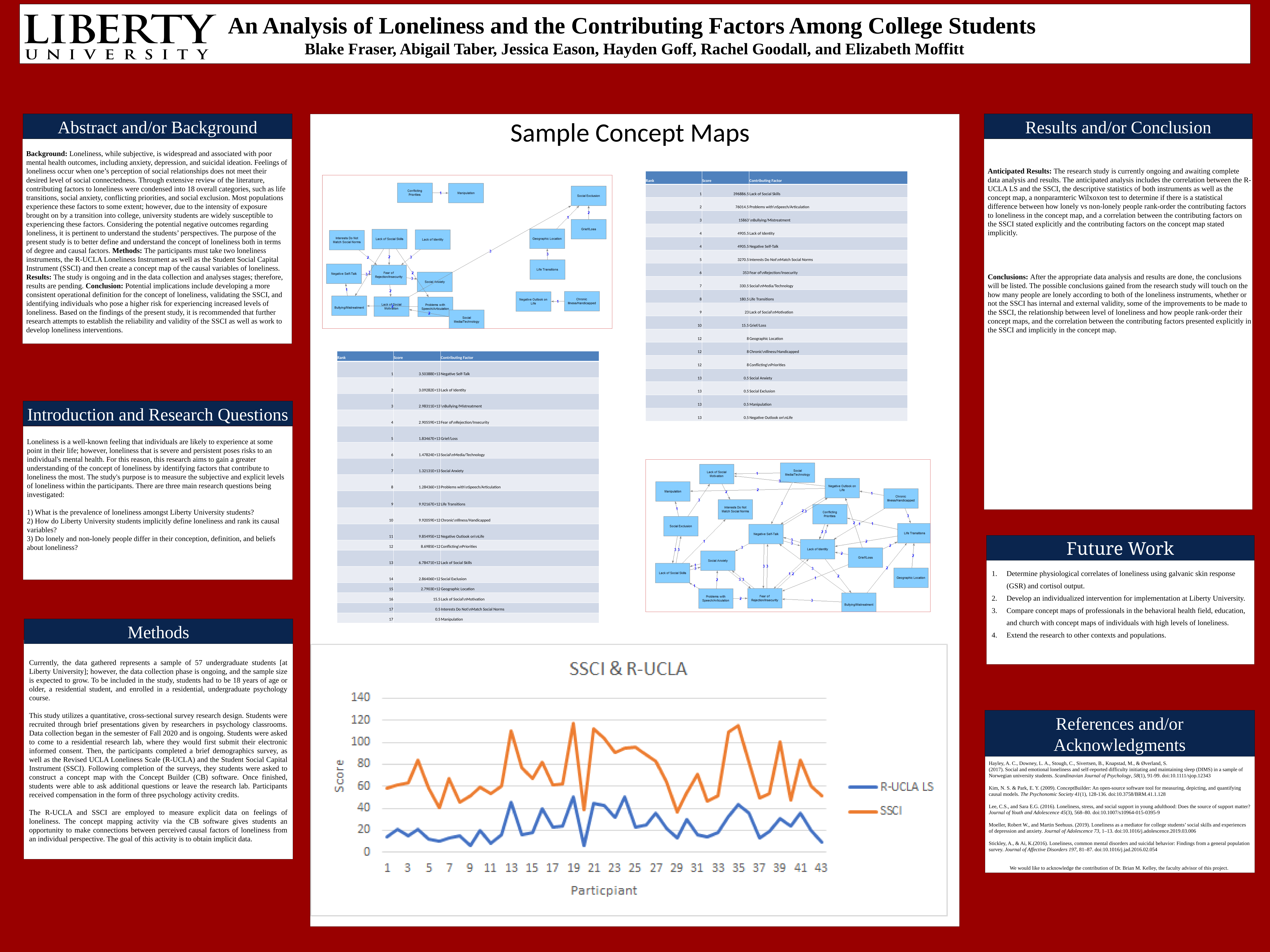
On the "SSCI & R-UCLA" chart, is the R-UCLA LS value for participant 19 greater or less than 60? less What is the label of the vertical axis on the "SSCI & R-UCLA" chart? Score What kind of chart is the "SSCI & R-UCLA" chart? line chart On the "SSCI & R-UCLA" chart, is the R-UCLA LS value for participant 1 greater or less than 20? less What are the two series named in the legend of the "SSCI & R-UCLA" chart? R-UCLA LS and SSCI On the "SSCI & R-UCLA" chart, which series generally has the higher scores across participants, R-UCLA LS or SSCI? SSCI On the "SSCI & R-UCLA" chart, is the SSCI value for participant 19 greater or less than 100? greater How many participants are plotted along the x axis of the "SSCI & R-UCLA" chart? 43 How many series does the legend of the "SSCI & R-UCLA" chart list? 2 On the "SSCI & R-UCLA" chart, which series has the larger value for participant 19, R-UCLA LS or SSCI? SSCI